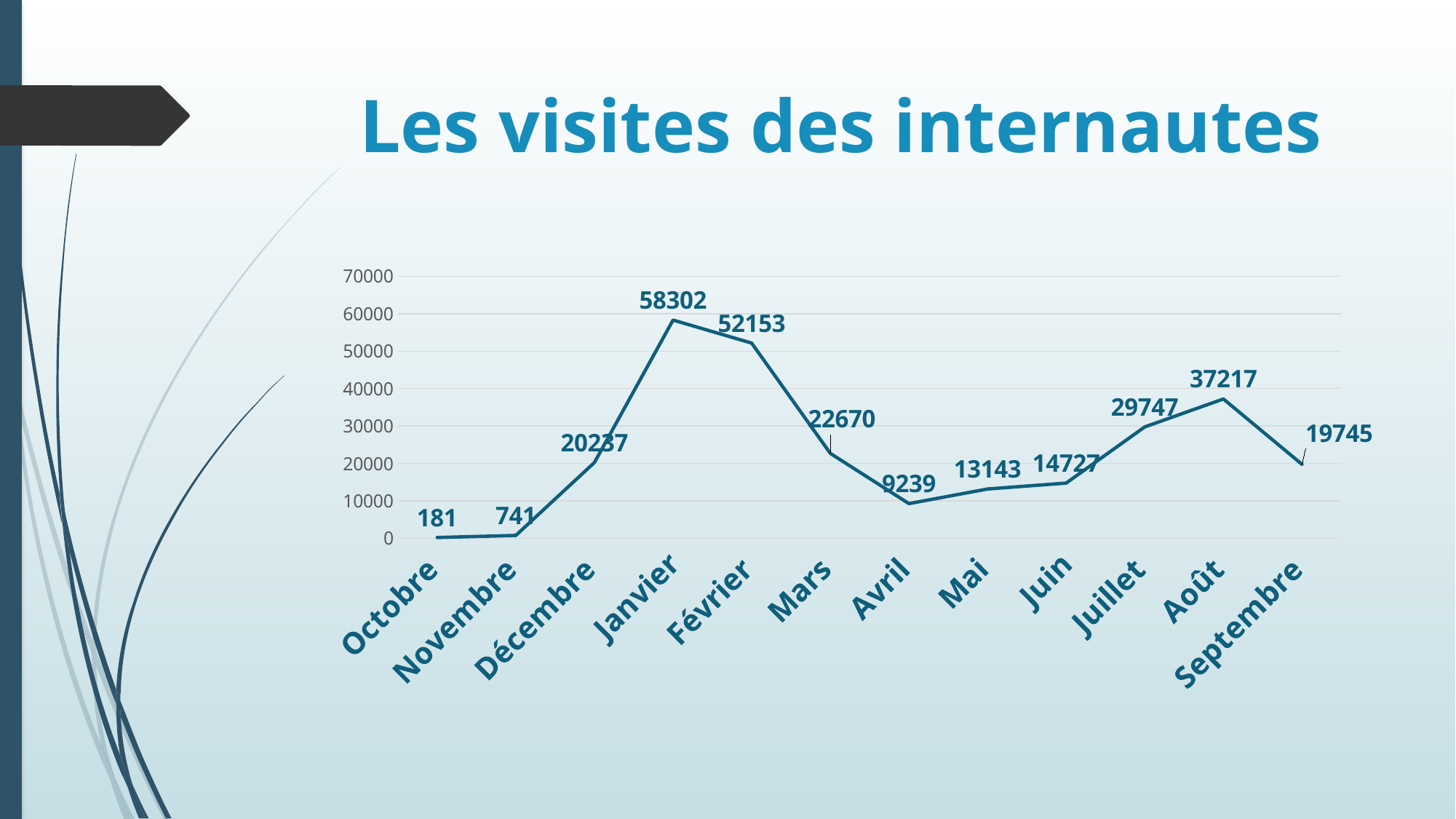
Which month has the lowest value? Octobre Which is larger, the value for Mars or the value for Juin? Mars What is the value for Janvier? 58302 What is the value for Avril? 9239 What kind of chart is shown on the slide? line chart What is the value for Septembre? 19745 Is the value for Août greater or less than 30000? greater What is the difference between the values for Août and Juillet? 7470 How many months are plotted on the chart? 12 What is the difference between the values for Janvier and Février? 6149 What is the title of the slide? Les visites des internautes Which month has the highest value? Janvier